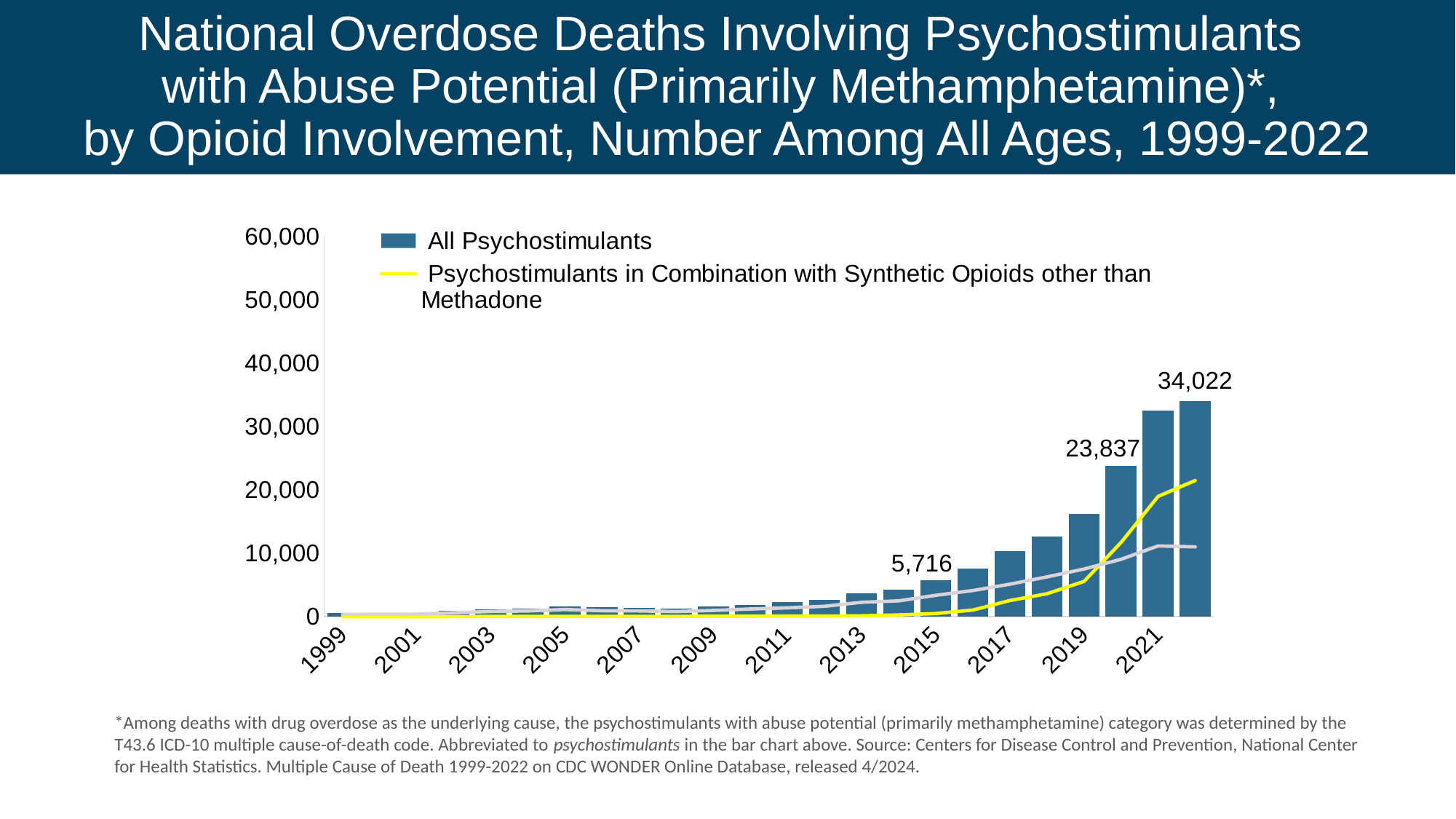
What is the difference between the All Psychostimulants values for 2020 and 2015? 18,121 What is the difference between the All Psychostimulants values for 2022 and 2020? 10,185 What is the value of the All Psychostimulants bar for 2020? 23,837 Do the All Psychostimulants values generally rise or fall from 1999 to 2022? rise Which year has the highest All Psychostimulants bar? 2022 Is the All Psychostimulants value for 2021 greater or less than 30,000? greater What is the value of the All Psychostimulants bar for 2015? 5,716 What is the value of the All Psychostimulants bar for 2022? 34,022 What colour is the line for Psychostimulants in Combination with Synthetic Opioids other than Methadone? yellow How many series does the legend list? 2 Is the All Psychostimulants value for 2019 greater or less than 20,000? less Which year has the larger All Psychostimulants value, 2015 or 2020? 2020